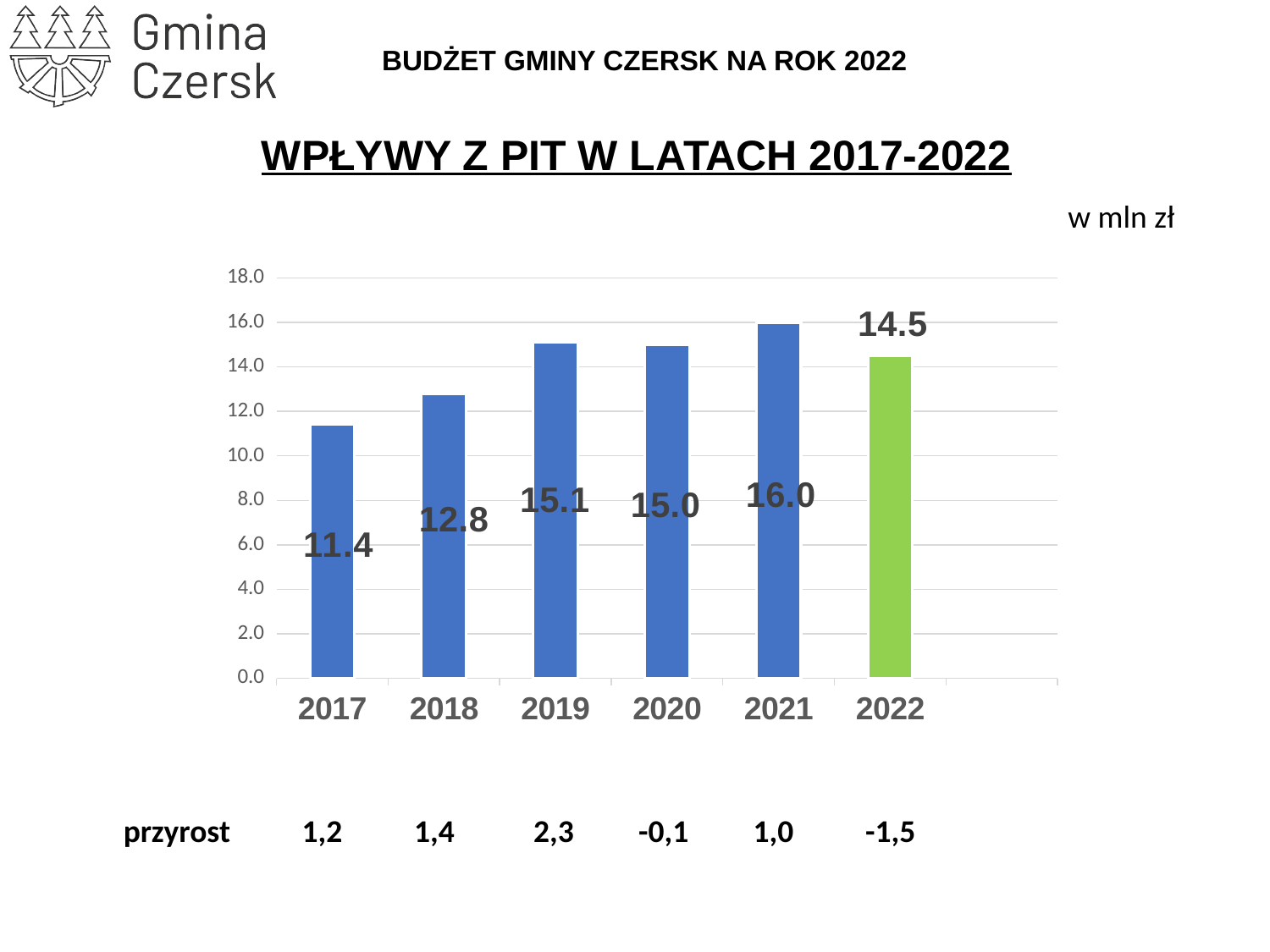
How many years are shown on the chart? 6 Which year has the lowest value? 2017 Which year has the highest value? 2021 What is the difference between the values for 2019 and 2017? 3.7 What is the value for 2022? 14.5 What is the value for 2020? 15.0 Which is larger, the value for 2018 or the value for 2022? 2022 Is the value for 2021 greater or less than 14.0? greater What is the value for 2017? 11.4 What is the difference between the values for 2021 and 2022? 1.5 What is the title of the chart? WPŁYWY Z PIT W LATACH 2017-2022 What kind of chart is shown on the slide? bar chart